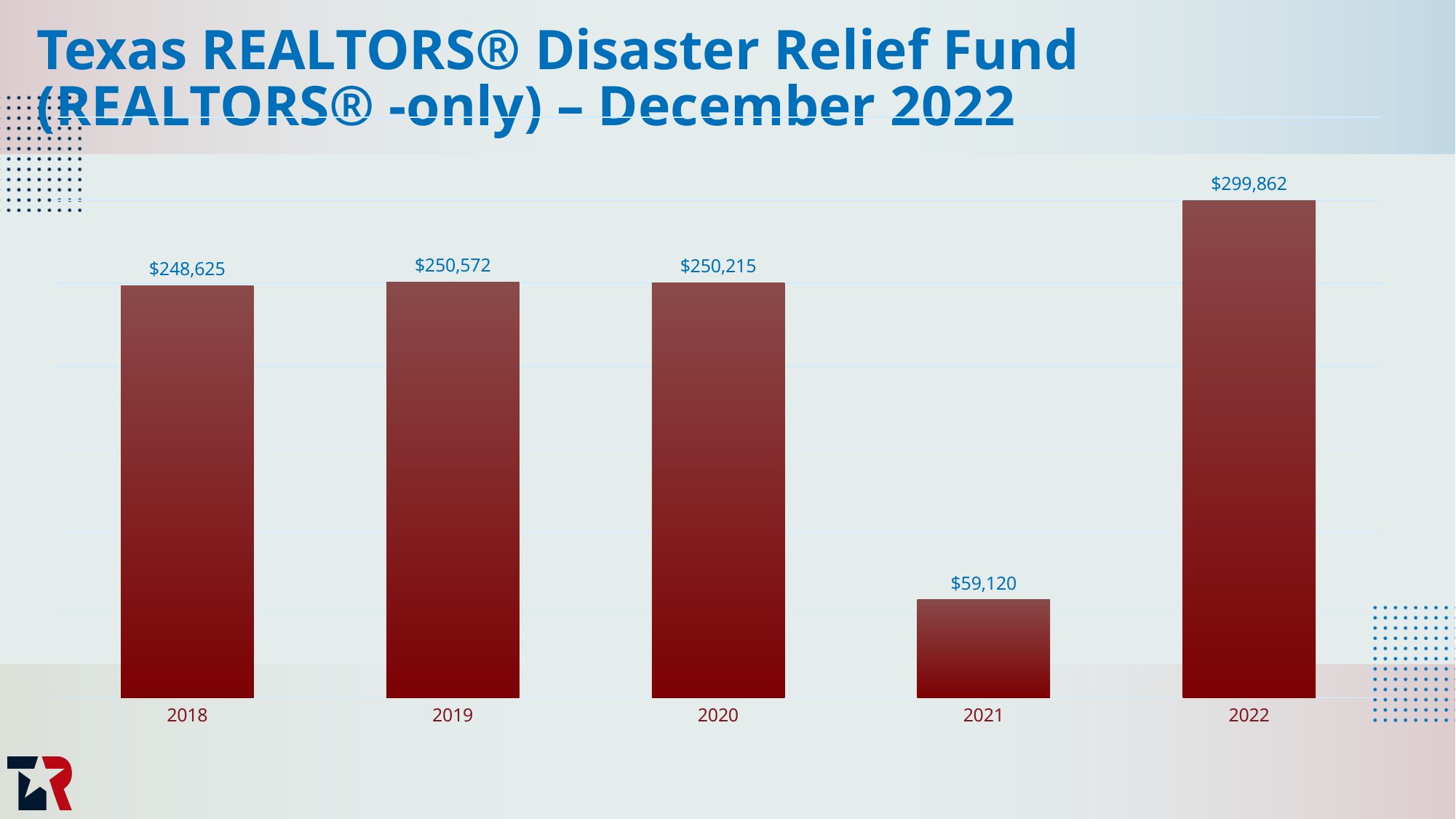
What is the value for 2020? $250,215 How many years are shown on the chart? 5 Which year has the highest value? 2022 Which is larger, the value for 2022 or the value for 2019? 2022 What is the title of the slide? Texas REALTORS® Disaster Relief Fund (REALTORS® -only) – December 2022 What kind of chart is this? Bar chart What is the value for 2021? $59,120 What is the difference between the values for 2019 and 2018? $1,947 What is the value for 2018? $248,625 What is the difference between the values for 2022 and 2021? $240,742 What is the value for 2022? $299,862 Which year has the lowest value? 2021